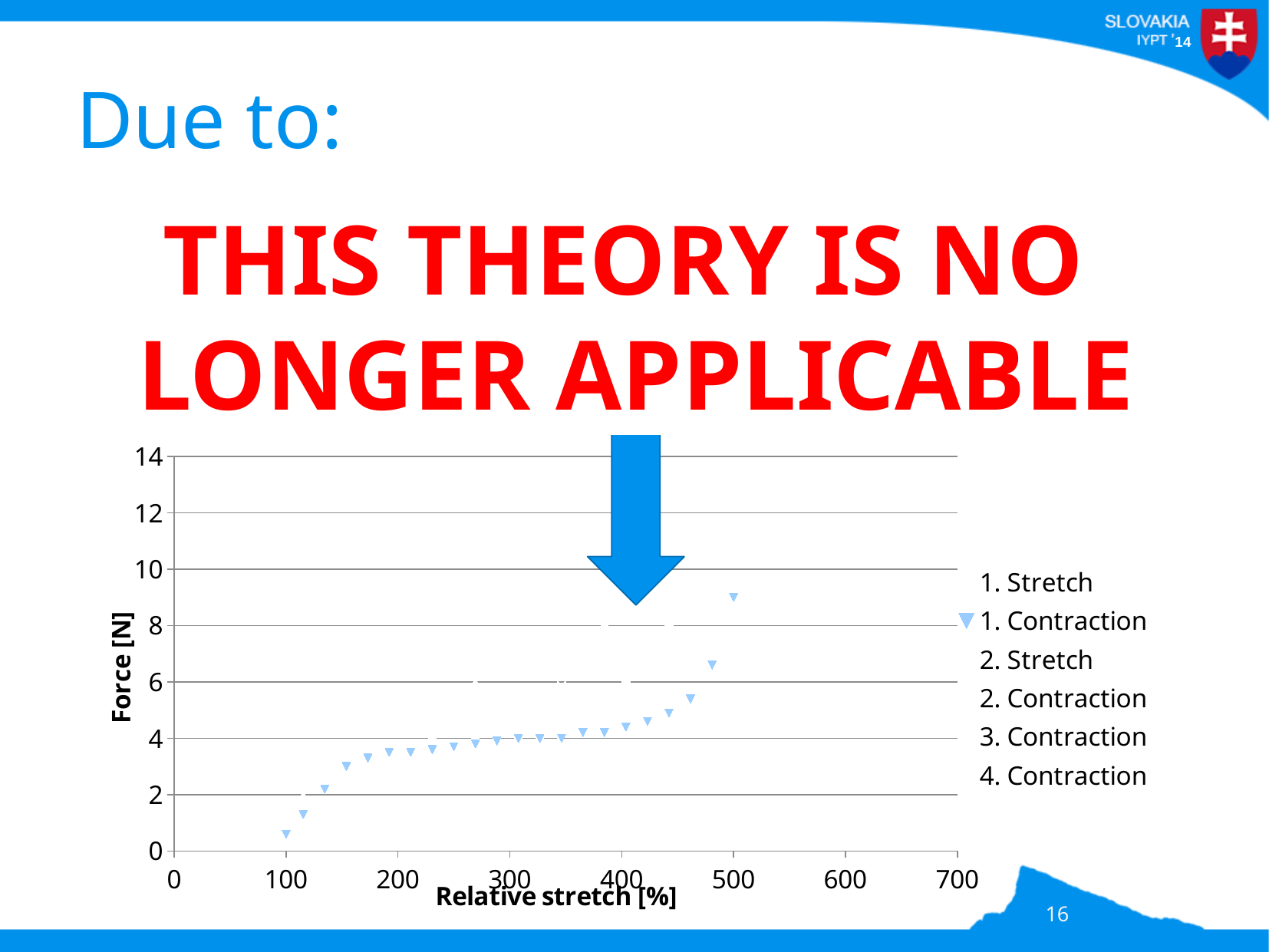
How many series does the chart's legend list? 6 Which series in the legend is shown with a triangle marker? 1. Contraction Do the plotted values of the 1. Contraction series rise or fall as relative stretch increases? rise Is the force value for 1. Contraction at a relative stretch of 200% greater or less than 4 N? less What is the label of the chart's vertical axis? Force [N] Is the force value for 1. Contraction at a relative stretch of 100% greater or less than 2 N? less What is the label of the chart's horizontal axis? Relative stretch [%] What kind of chart is shown on the slide? scatter chart Is the force value for 1. Contraction at a relative stretch of 450% greater or less than 4 N? greater